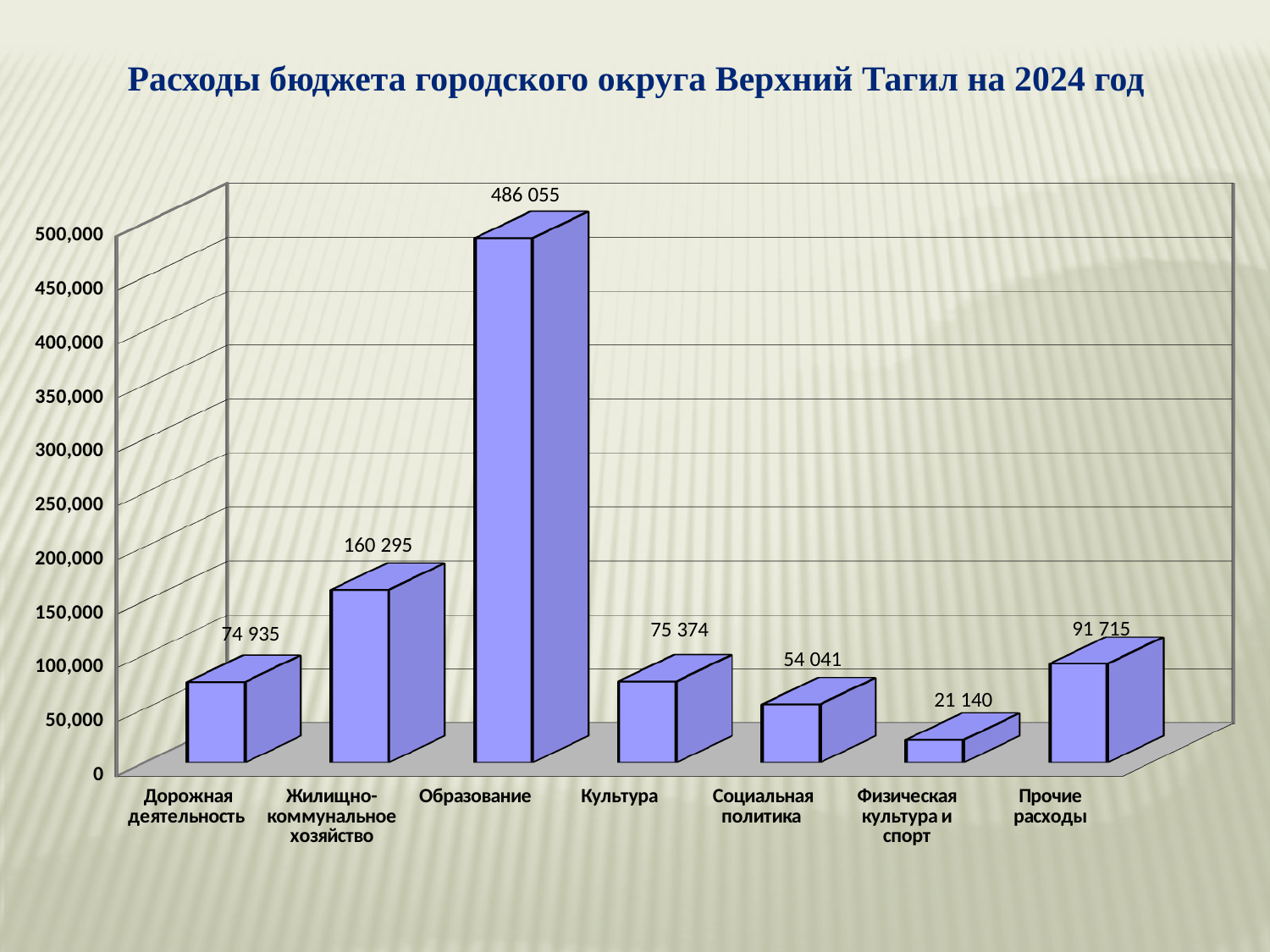
What is the value for Жилищно-коммунальное хозяйство? 160 295 What is the difference between the values for Образование and Жилищно-коммунальное хозяйство? 325 760 What is the value for Прочие расходы? 91 715 What is the value for Физическая культура и спорт? 21 140 Is the value for Жилищно-коммунальное хозяйство greater or less than 150,000? greater How many categories are shown in the chart? 7 Which category has the highest value? Образование What is the difference between the values for Прочие расходы and Социальная политика? 37 674 What kind of chart is shown on the slide? Bar chart Which category has the lowest value? Физическая культура и спорт What is the value for Образование? 486 055 Which is larger, the value for Социальная политика or the value for Прочие расходы? Прочие расходы